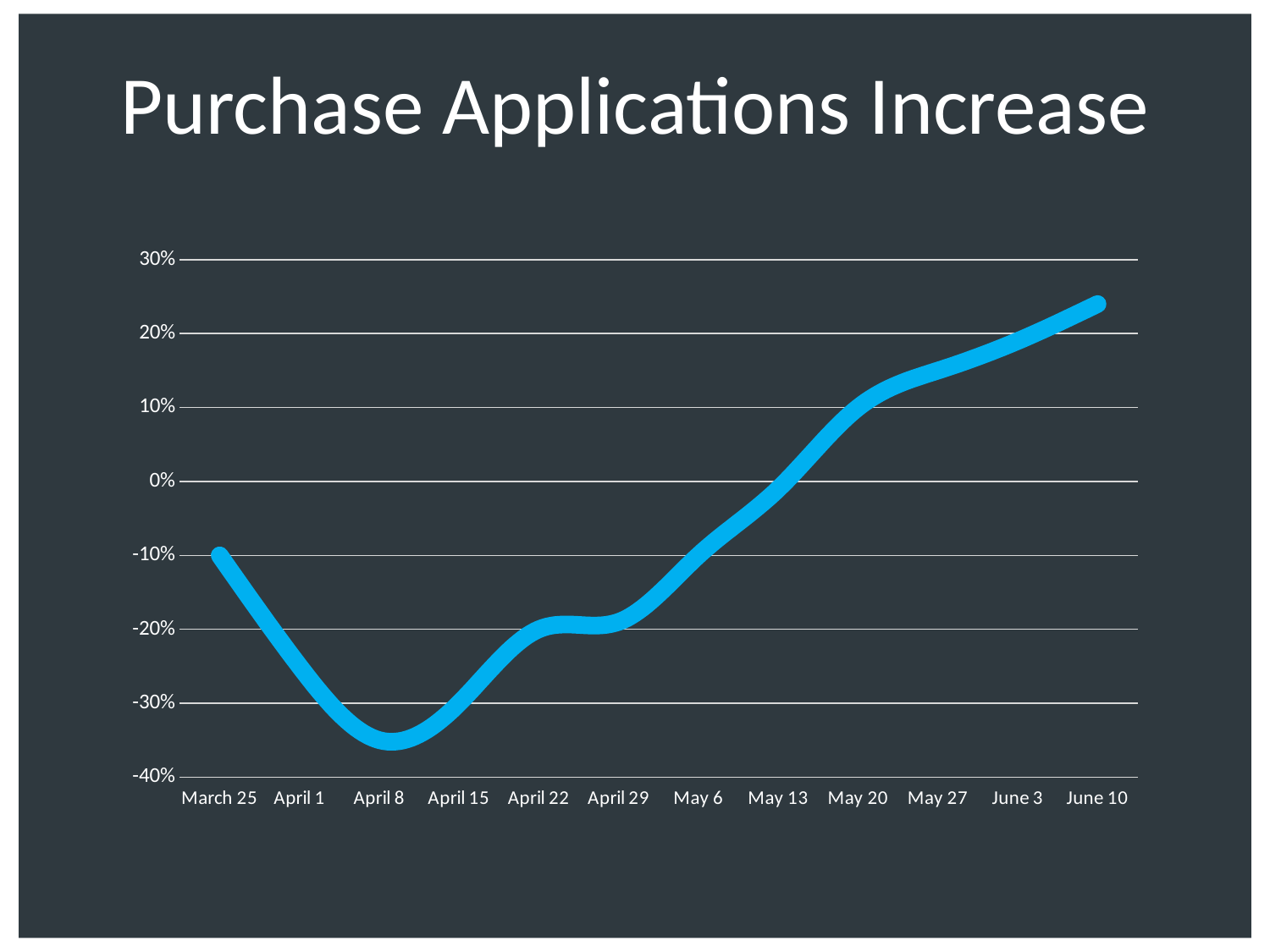
Is the value for April 22 greater or less than -10%? less Which has the larger value, March 25 or June 10? June 10 What kind of chart is shown on the slide? line chart Which date has the highest value on the chart? June 10 Is the value for April 8 greater or less than -30%? less Is the value for June 10 greater or less than 20%? greater Which date has the lowest value on the chart? April 8 How many dates are plotted along the x axis? 12 Do the values rise or fall from April 8 to June 10? rise What is the title of the chart? Purchase Applications Increase